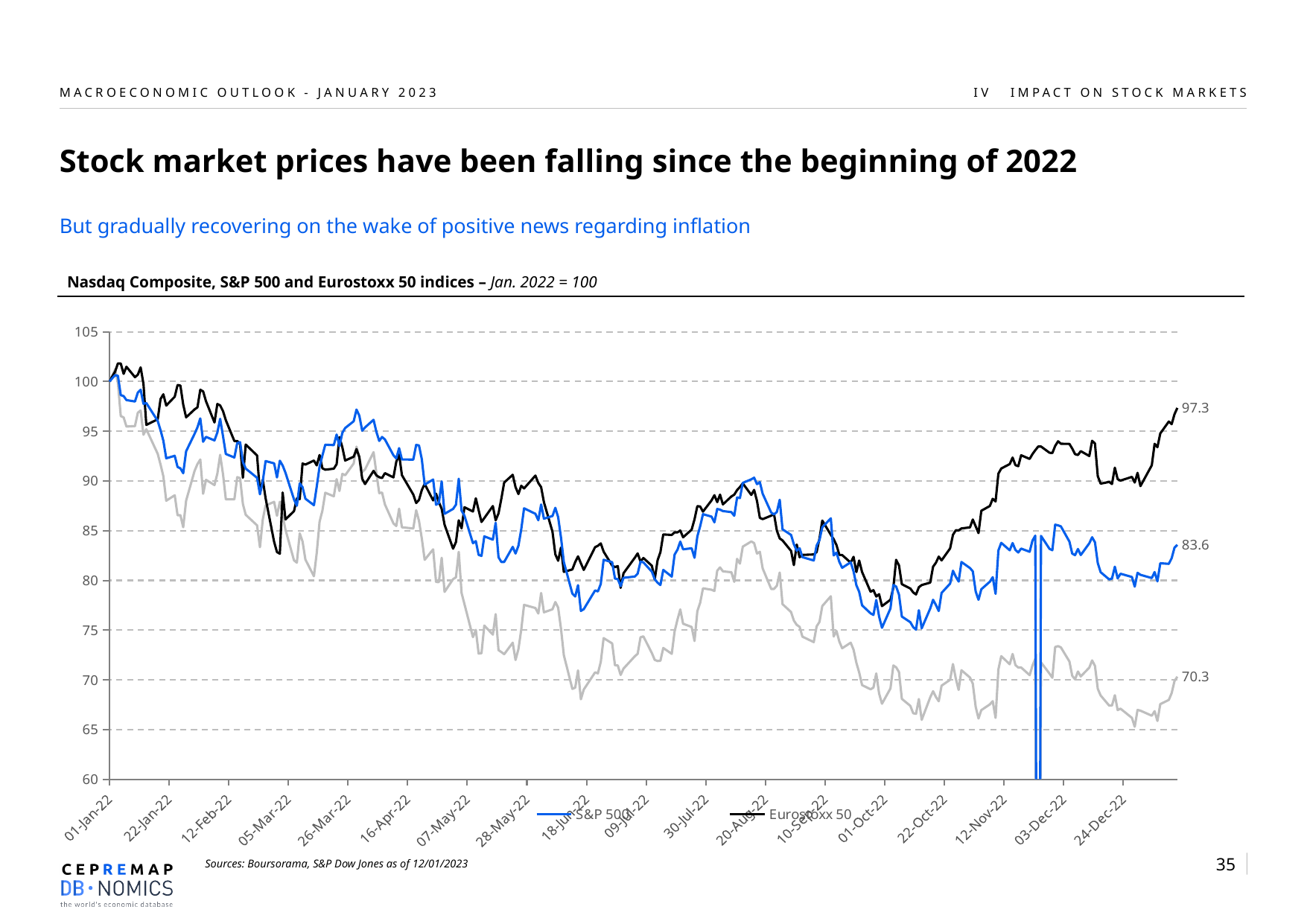
Is the value of the grey line around 24-Dec-22 greater or less than 70? less Is the value of the Eurostoxx 50 line around 12-Nov-22 greater or less than 85? greater What is the final value shown for the Eurostoxx 50 line? 97.3 What base period is used for the indices, according to the chart title? Jan. 2022 = 100 At the right end of the chart, which is higher: the S&P 500 or the Eurostoxx 50? Eurostoxx 50 What type of chart is shown on the slide? line chart Which line ends at the lowest value at the right end of the chart? the grey line (70.3) Which index ends at the highest value at the right end of the chart? Eurostoxx 50 What is the difference between the final values of the Eurostoxx 50 (97.3) and the S&P 500 (83.6)? 13.7 What is the final value shown for the grey line at the right end of the chart? 70.3 What is the final value shown for the S&P 500 line? 83.6 How many index series are plotted on the chart? 3